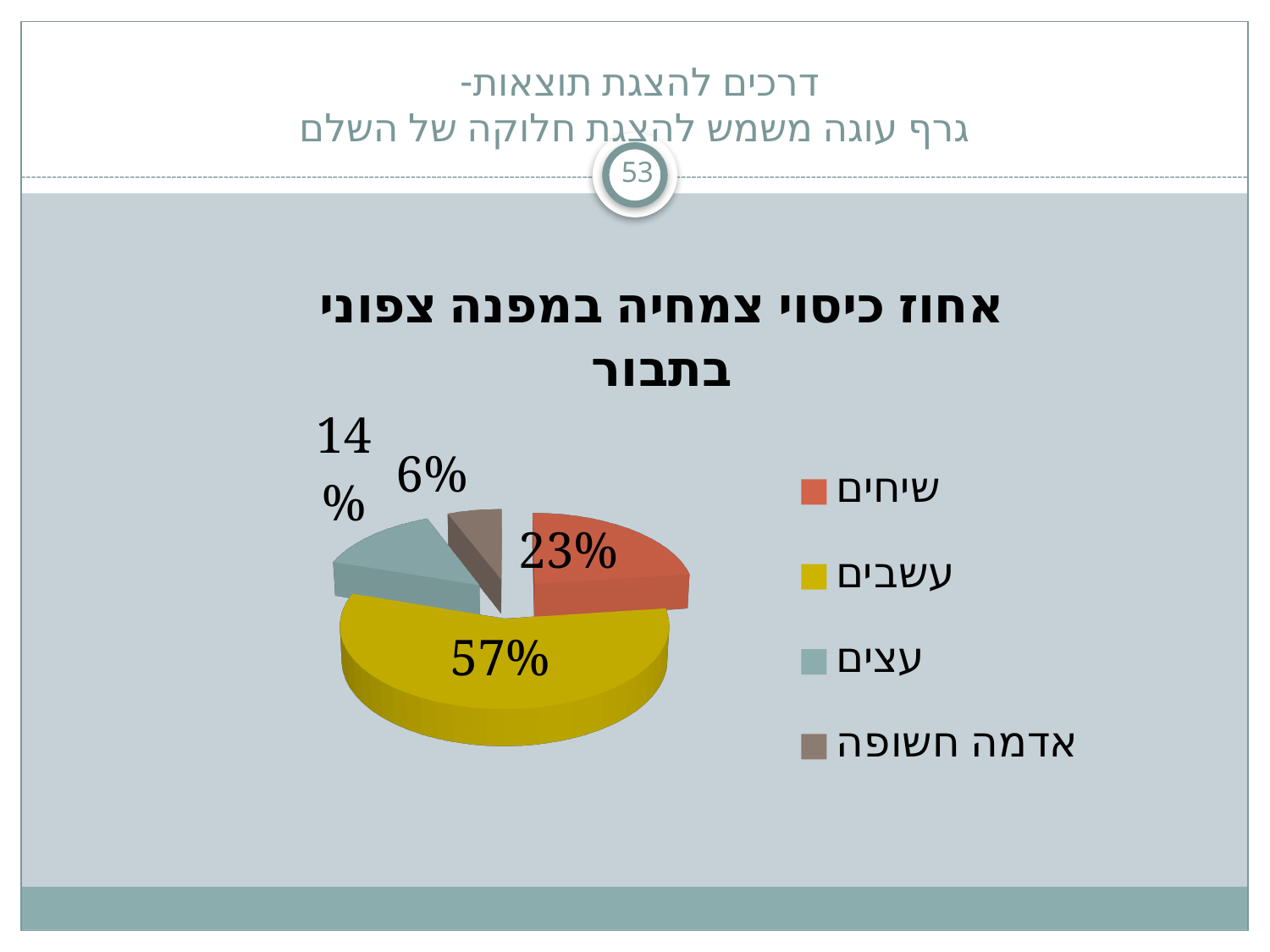
What colour is the slice for עשבים? Yellow What kind of chart is shown on the slide? Pie chart Which category has the largest slice of the pie? עשבים What percentage of the pie is עשבים? 57% What percentage of the pie is שיחים? 23% What percentage of the pie is אדמה חשופה? 6% Which is larger, the slice for עצים or the slice for שיחים? שיחים What percentage of the pie is עצים? 14% What is the title of the chart? אחוז כיסוי צמחיה במפנה צפוני בתבור Which category has the smallest slice of the pie? אדמה חשופה What is the difference in percentage points between עשבים and שיחים? 34 How many categories does the legend list? 4